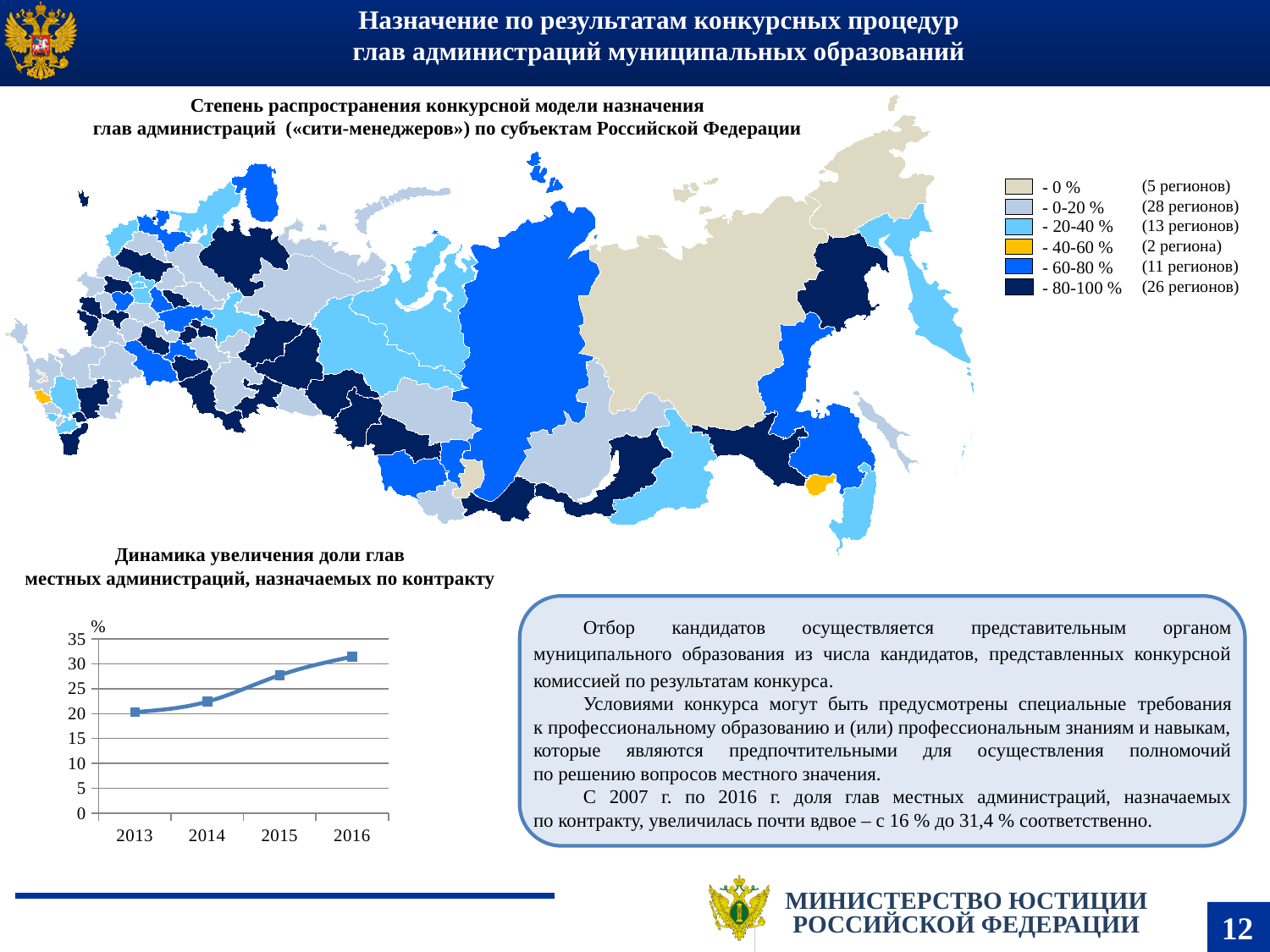
In the line chart at the bottom left, how many years are plotted on the x axis? 4 In the line chart at the bottom left, is the value for 2015 greater or less than 25? greater In the line chart at the bottom left, is the value for 2014 greater or less than 25? less In the line chart at the bottom left, what is the highest tick value shown on the vertical axis? 35 In the line chart at the bottom left, which year has the lowest value? 2013 In the line chart at the bottom left, which year has the highest value? 2016 In the line chart at the bottom left, which year has the larger value, 2014 or 2015? 2015 In the line chart at the bottom left, do the values rise or fall from 2013 to 2016? rise In the line chart at the bottom left, is the value for 2013 greater or less than 25? less What kind of chart is the 'Динамика увеличения доли глав местных администраций, назначаемых по контракту' chart? line chart In the line chart at the bottom left, what unit is shown at the top of the vertical axis? %